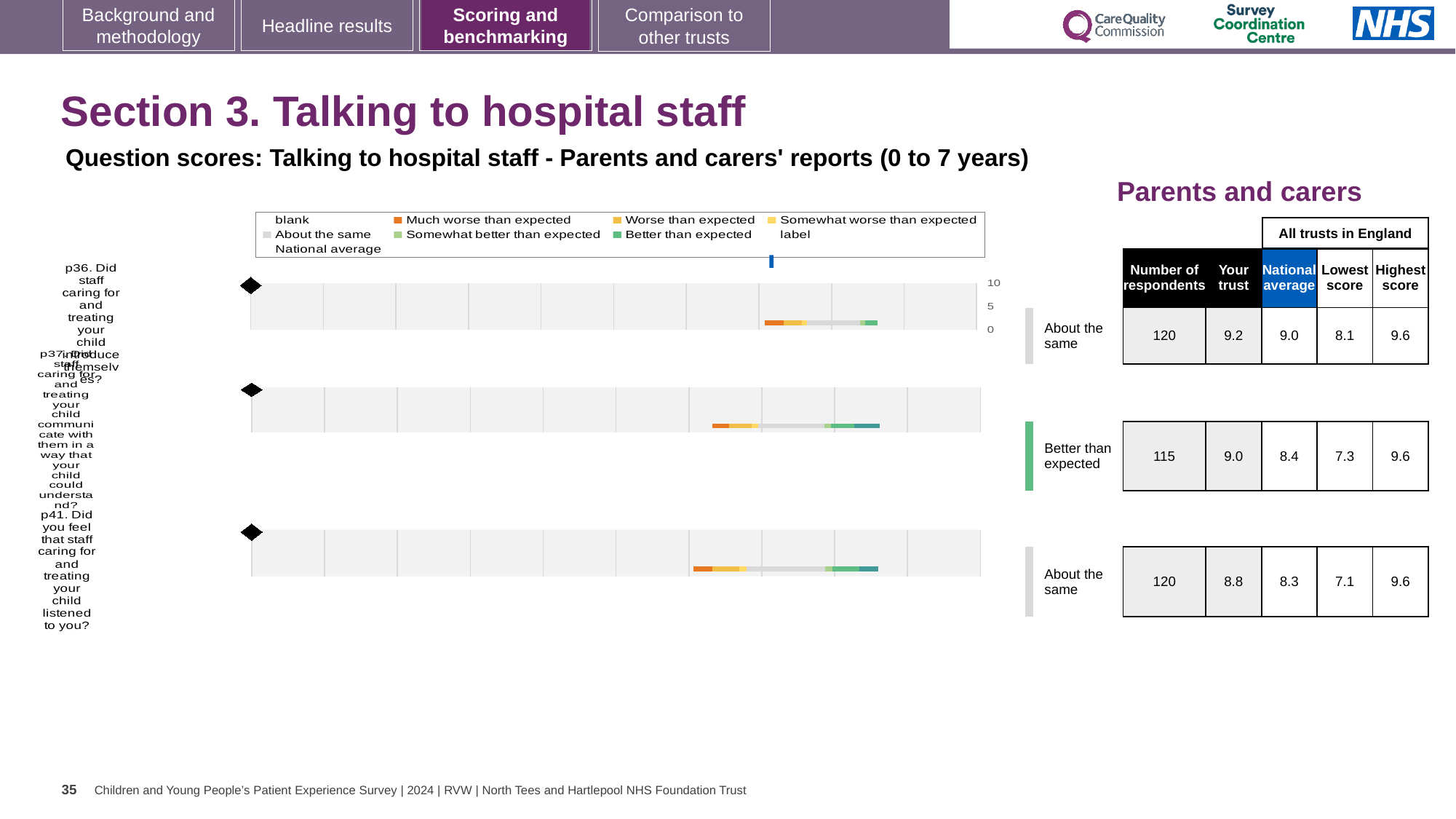
What kind of chart is used for each question row on the slide? bar chart How many question rows (charts) are shown on the slide? 3 What benchmark category is shown for the second row (p37)? Better than expected How many respondents answered the second row question (p37)? 115 What is the 'Your trust' score for the first row (p36, staff introducing themselves)? 9.2 What is the difference between the trust score and the national average for the second row (p37)? 0.6 Which of the three question rows has the lowest national average? p41 (8.3) What is the highest score across all trusts in England for the first row (p36)? 9.6 What is the lowest score across all trusts in England for the third row (p41, staff listened to you)? 7.1 What is the national average for the second row (p37, staff communicating in a way the child could understand)? 8.4 Which of the three question rows has the highest 'Your trust' score? p36 (9.2) Is the trust score for the first row (p36) higher or lower than the trust score for the third row (p41)? higher